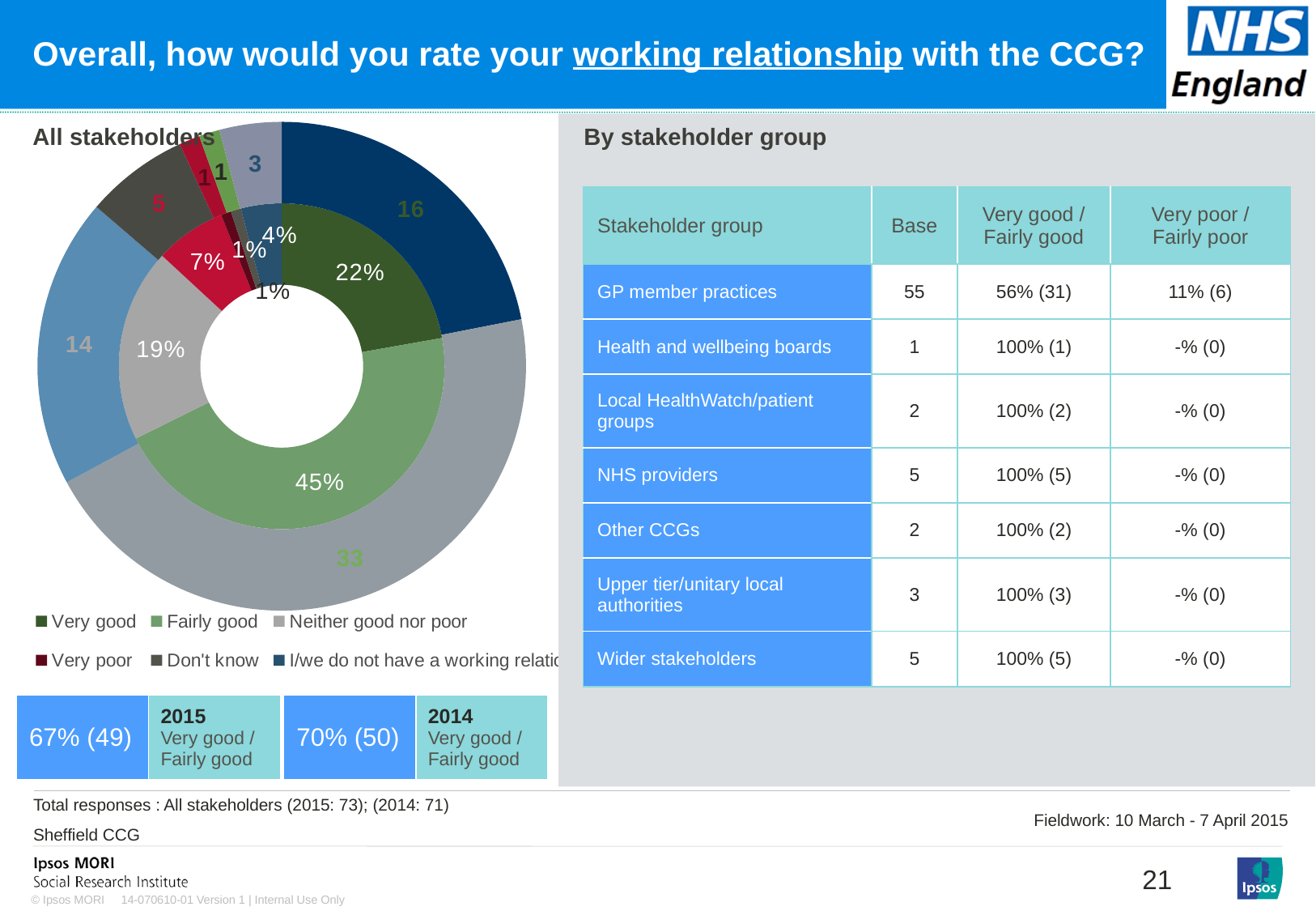
In the All stakeholders doughnut chart, what percentage rated the working relationship as Very good? 22% In the All stakeholders chart, what colour is used for the Fairly good category in the legend? Light green In the All stakeholders doughnut chart, what is the difference in percentage points between the Fairly good share and the Very good share? 23 percentage points In the All stakeholders doughnut chart, is the Fairly good share greater or less than 40%? greater In the All stakeholders doughnut chart, what percentage of respondents rated the working relationship as Fairly good? 45% What type of chart is used to show the All stakeholders results? Doughnut (pie) chart How many entries are listed in the legend of the All stakeholders chart? 6 In the All stakeholders doughnut chart, what is the difference in percentage points between the Very good share and the Neither good nor poor share? 3 percentage points In the All stakeholders doughnut chart, which is larger: the Very good share or the Neither good nor poor share? Very good In the All stakeholders doughnut chart, what percentage answered Neither good nor poor? 19% In the All stakeholders doughnut chart, which rating category has the largest share? Fairly good What is the title of the chart on the left of the slide? All stakeholders